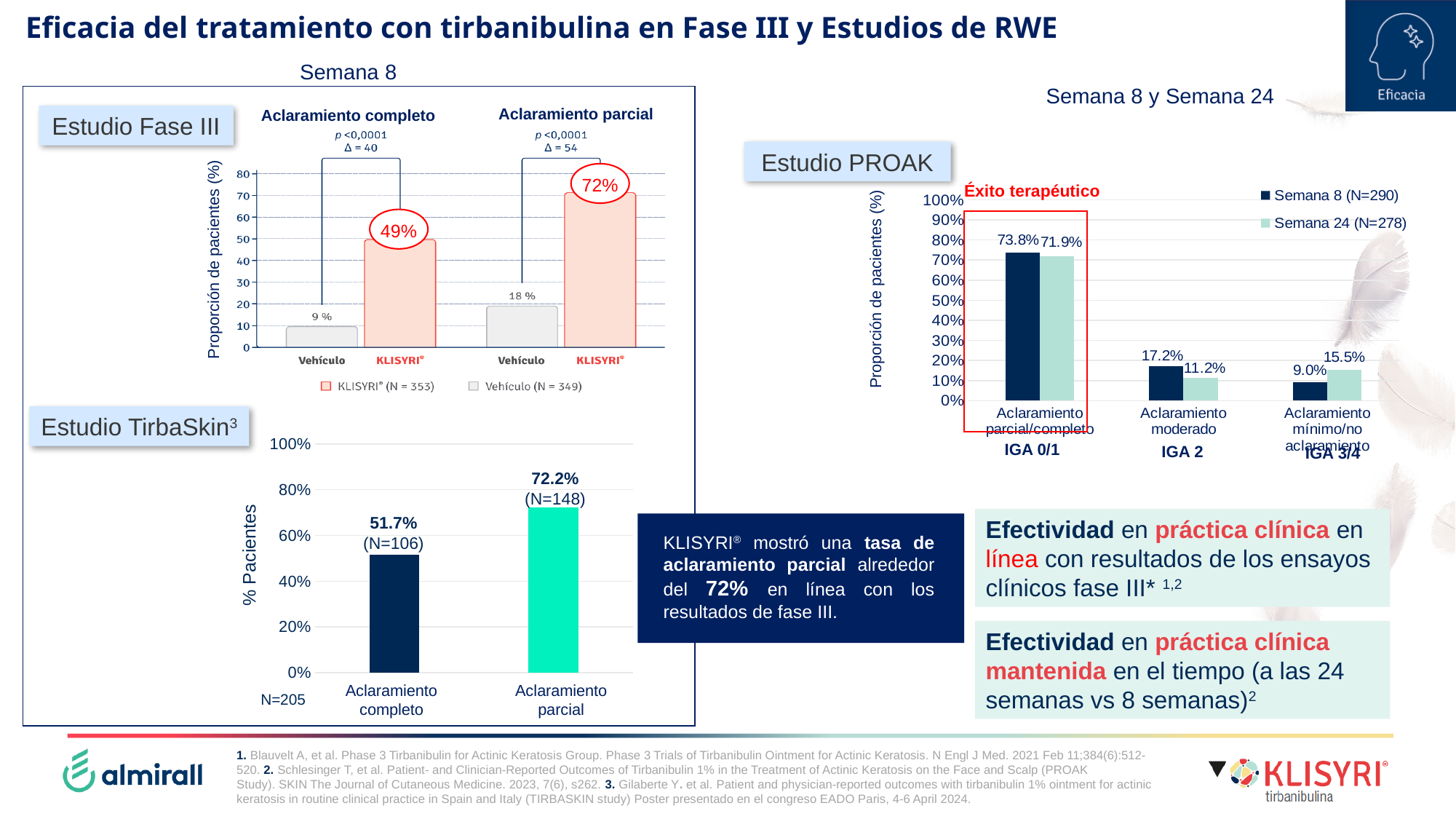
In the Estudio Fase III chart, what is the difference between KLISYRI and Vehículo under Aclaramiento completo? 40 In the Estudio PROAK chart, what is the Semana 24 value for Aclaramiento moderado (IGA 2)? 11.2% In the Estudio Fase III chart, what is the value for KLISYRI under Aclaramiento completo? 49% In the Estudio PROAK chart, which is larger for IGA 3/4: Semana 8 or Semana 24? Semana 24 In the Estudio PROAK chart, how many categories are shown on the x axis? 3 What kind of chart is the Estudio TirbaSkin chart? Bar chart In the Estudio Fase III chart, how many series does the legend list? 2 In the Estudio TirbaSkin chart, what is the difference between Aclaramiento parcial and Aclaramiento completo? 20.5% In the Estudio Fase III chart, what is the value for Vehículo under Aclaramiento parcial? 18 % In the Estudio TirbaSkin chart, what is the value for Aclaramiento parcial? 72.2% In the Estudio PROAK chart, what is the sample size (N) for the Semana 8 series in the legend? N=290 In the Estudio TirbaSkin chart, which category has the lowest value? Aclaramiento completo